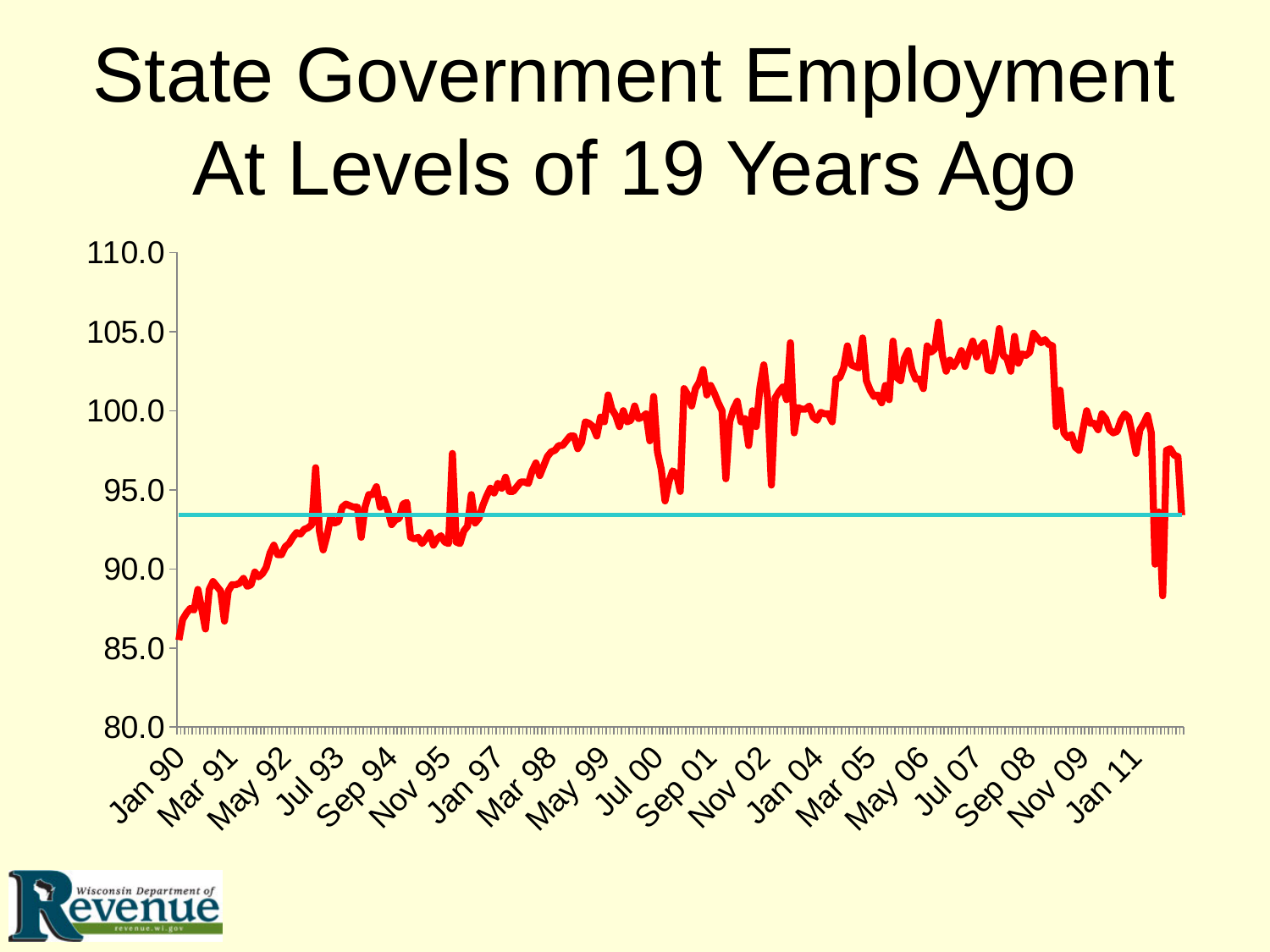
Is the value for Jul 07 greater or less than 100.0? greater What is the lowest value shown on the y axis? 80.0 Is the value for Jan 90 greater or less than 90.0? less Is the value for May 92 greater or less than 95.0? less What is the title of the chart on the slide? State Government Employment At Levels of 19 Years Ago Which is larger, the value for Jul 07 or the value for Jan 90? Jul 07 Does the red line generally rise or fall from Jan 90 to Jul 07? rise How many date labels are shown along the x axis? 19 What is the highest value shown on the y axis? 110.0 What kind of chart is shown on the slide? line chart